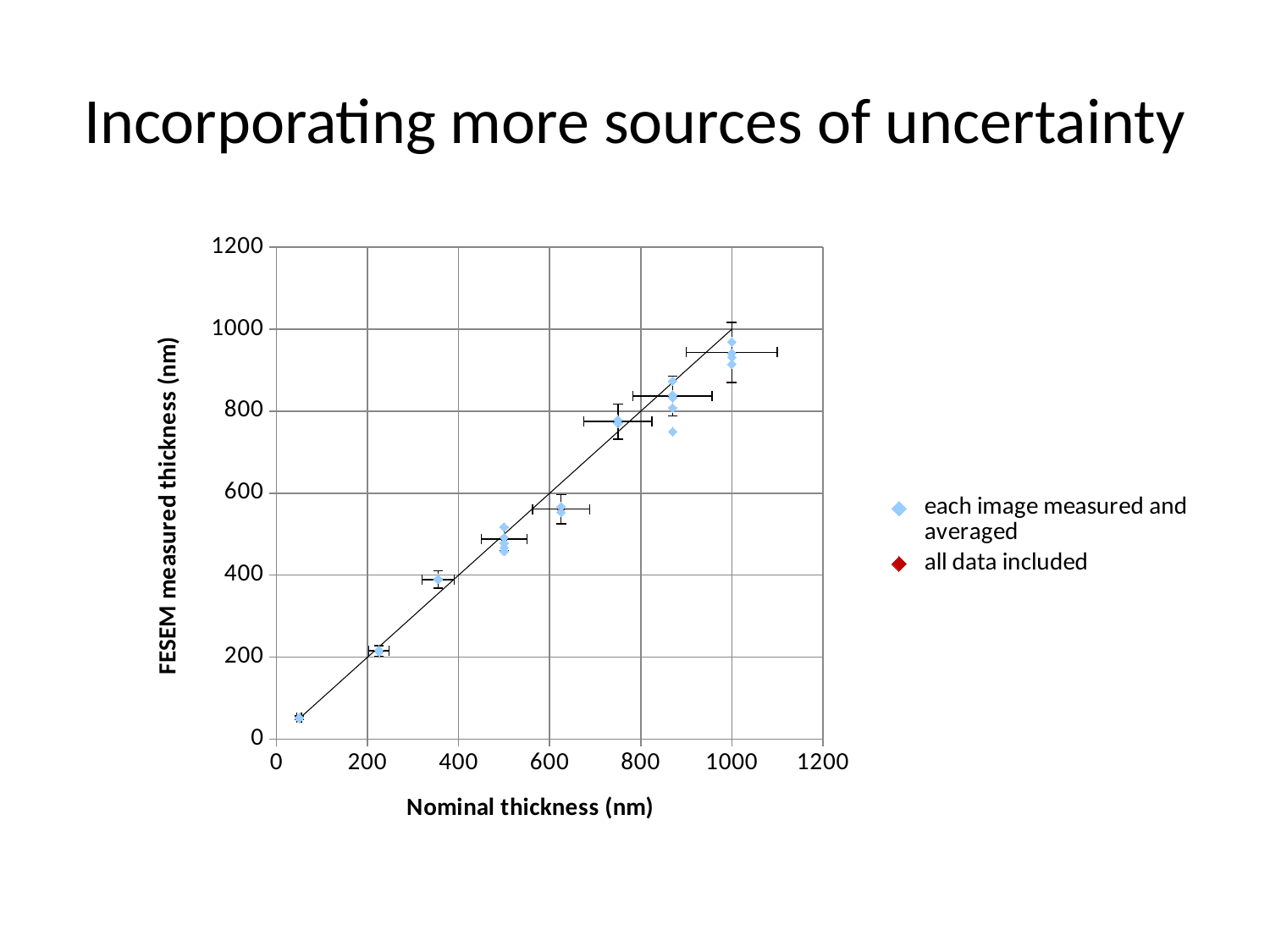
Do the measured thickness values rise or fall as nominal thickness increases? rise Which nominal thickness has the highest FESEM measured thickness? 1000 What is the title of the x axis? Nominal thickness (nm) How many series does the legend list? 2 What is the maximum value shown on the y axis? 1200 What is the title of the y axis? FESEM measured thickness (nm) What kind of chart is shown on the slide? scatter chart Is the FESEM measured thickness for a nominal thickness of 1000 nm greater or less than 800? greater